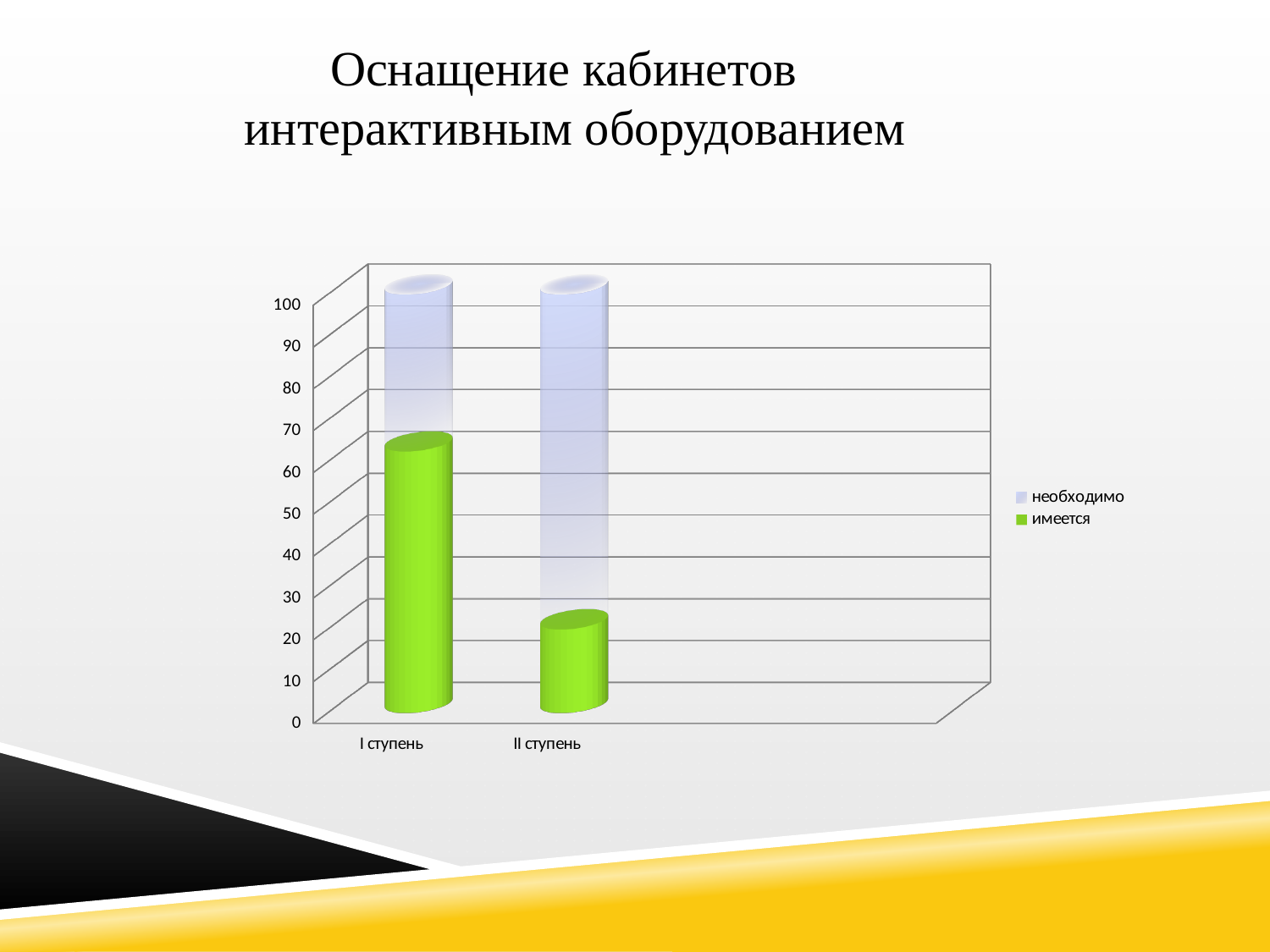
How many categories are shown on the x axis of the chart? 2 Which category has the higher value for 'имеется', I ступень or II ступень? I ступень Is the value of 'имеется' for II ступень greater or less than 30? less For I ступень, which series has the larger value, 'необходимо' or 'имеется'? имеется What is the title of the slide containing the chart? Оснащение кабинетов интерактивным оборудованием What kind of chart is shown on the slide? bar chart What are the two series named in the chart's legend? необходимо, имеется Is the value of 'необходимо' for II ступень greater or less than 90? less How many series does the chart's legend list? 2 Does the 'имеется' series rise or fall from I ступень to II ступень? fall Is the value of 'имеется' for I ступень greater or less than 50? greater Which category has the lowest value for the 'имеется' series? II ступень